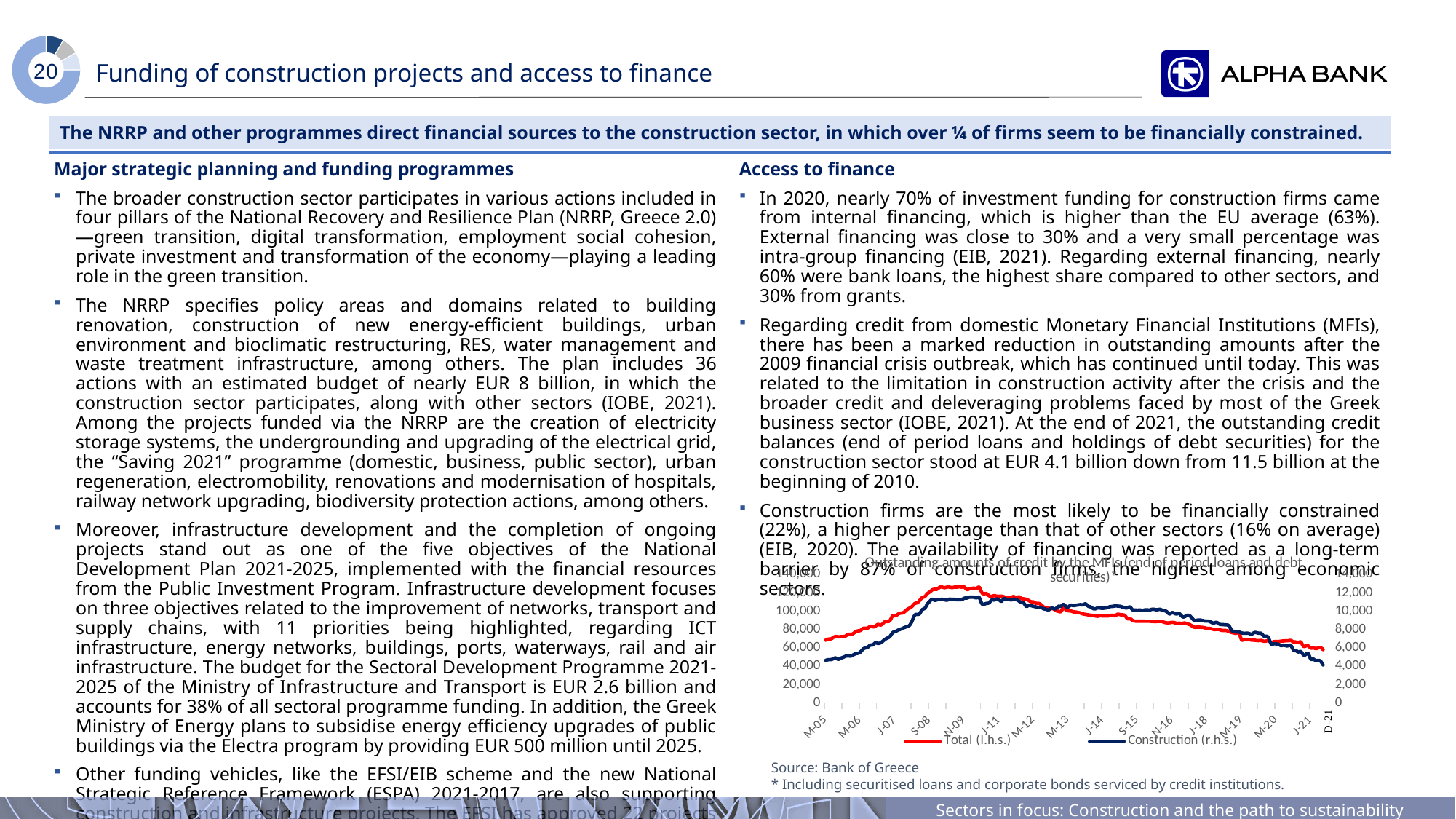
How many series does the chart's legend list? 2 Does the Total series rise or fall between M-05 and S-08? Rise Is the peak value of the Construction series greater or less than 10,000 on the right axis? greater Is the value of the Total series at M-05 greater or less than 80,000 on the left axis? less Is the peak value of the Total series greater or less than 100,000 on the left axis? greater How many date labels are shown on the x axis of the chart? 16 Which series is plotted in red in the chart? Total (l.h.s.) Which axis does the Construction series use, according to the legend? Right-hand side (r.h.s.) What kind of chart is shown on the slide? Line chart Does the Construction series rise or fall from its peak around 2010 to the end of the period in 2021? Fall